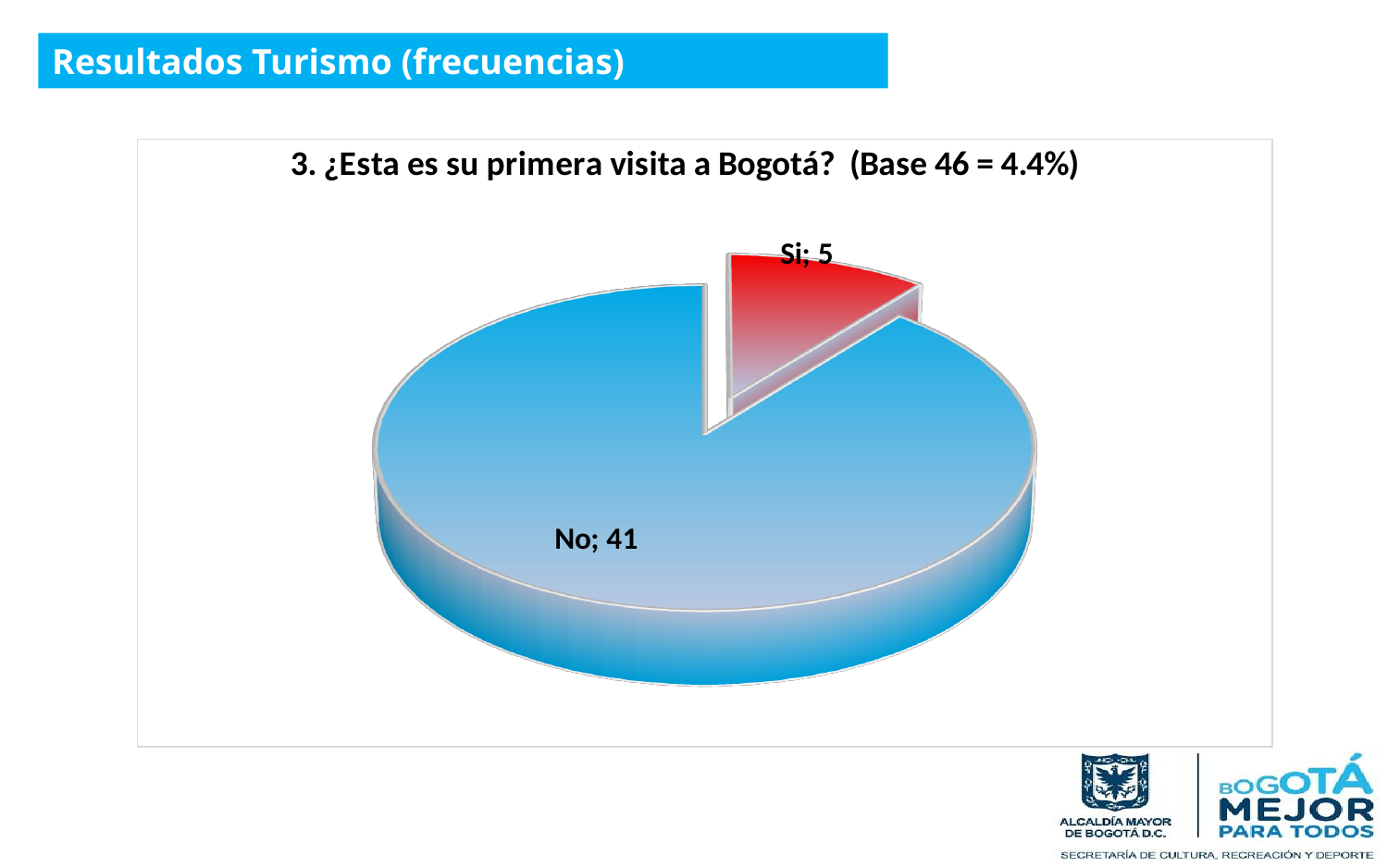
What share of the total of 46 does the "Si" slice represent, rounded to the nearest whole percent? 11% Which is larger, the value for "Si" or the value for "No"? No What is the value for the "No" slice? 41 What is the title of the pie chart? 3. ¿Esta es su primera visita a Bogotá? (Base 46 = 4.4%) What is the total of the two slice values shown on the pie chart? 46 What kind of chart is shown on the slide? pie chart Which category has the largest slice of the pie? No How many slices does the pie chart have? 2 What is the value for the "Si" slice? 5 What colour is the "Si" slice of the pie chart? red What is the difference between the "No" value and the "Si" value? 36 Which category has the smallest slice of the pie? Si